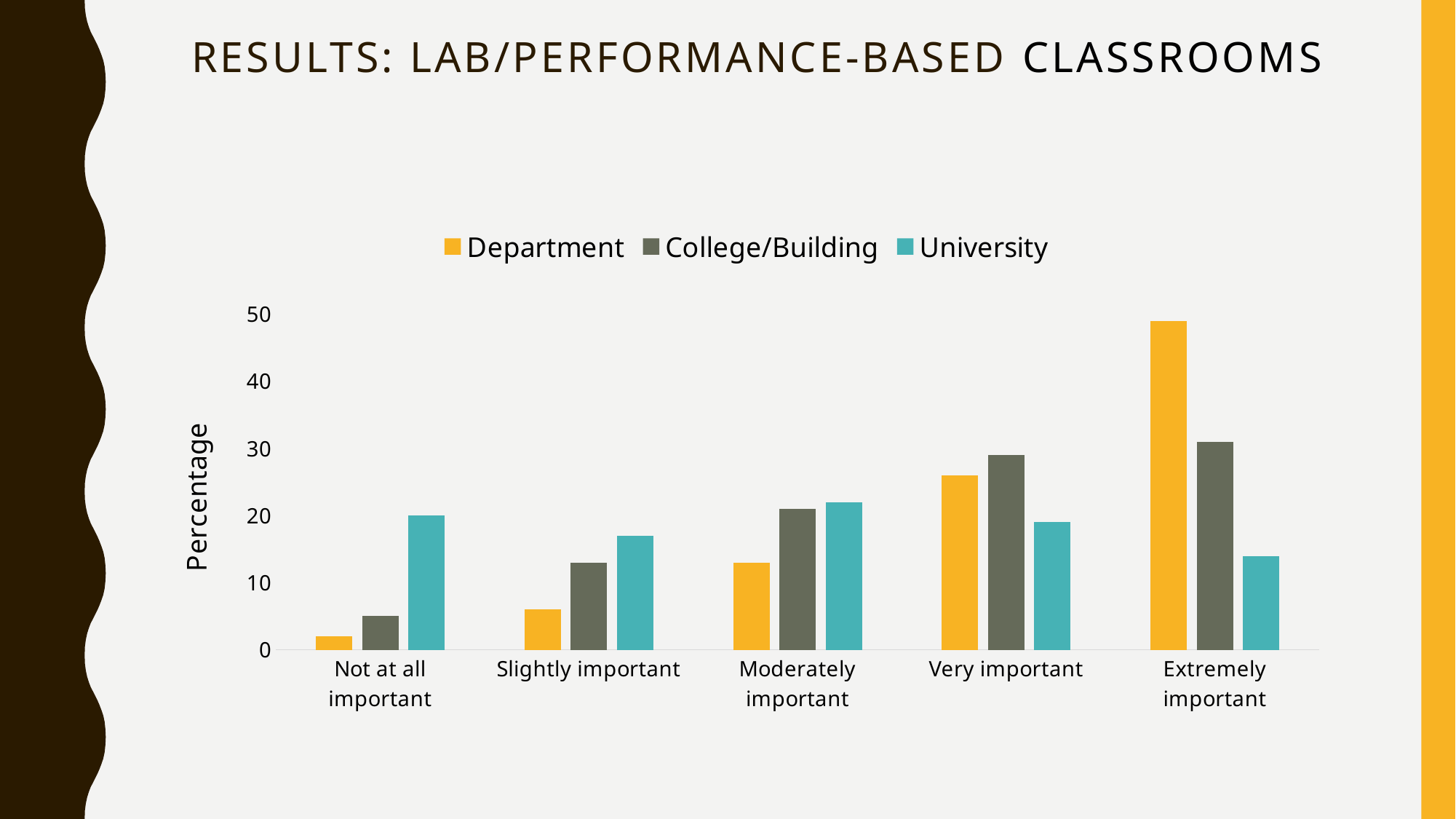
Is the University value for Not at all important greater or less than 10? greater What is the title of the slide? Results: Lab/Performance-Based Classrooms For which category is the University series lowest? Extremely important For Very important, which is larger: the Department value or the University value? Department Is the College/Building value for Moderately important greater or less than 30? less What kind of chart is shown on the slide? bar chart Is the Department value for Extremely important greater or less than 40? greater How many series does the legend list? 3 What is the title of the y axis? Percentage For which category is the Department series highest? Extremely important Do the Department values rise or fall moving from Not at all important to Extremely important? rise How many categories are shown along the x axis? 5